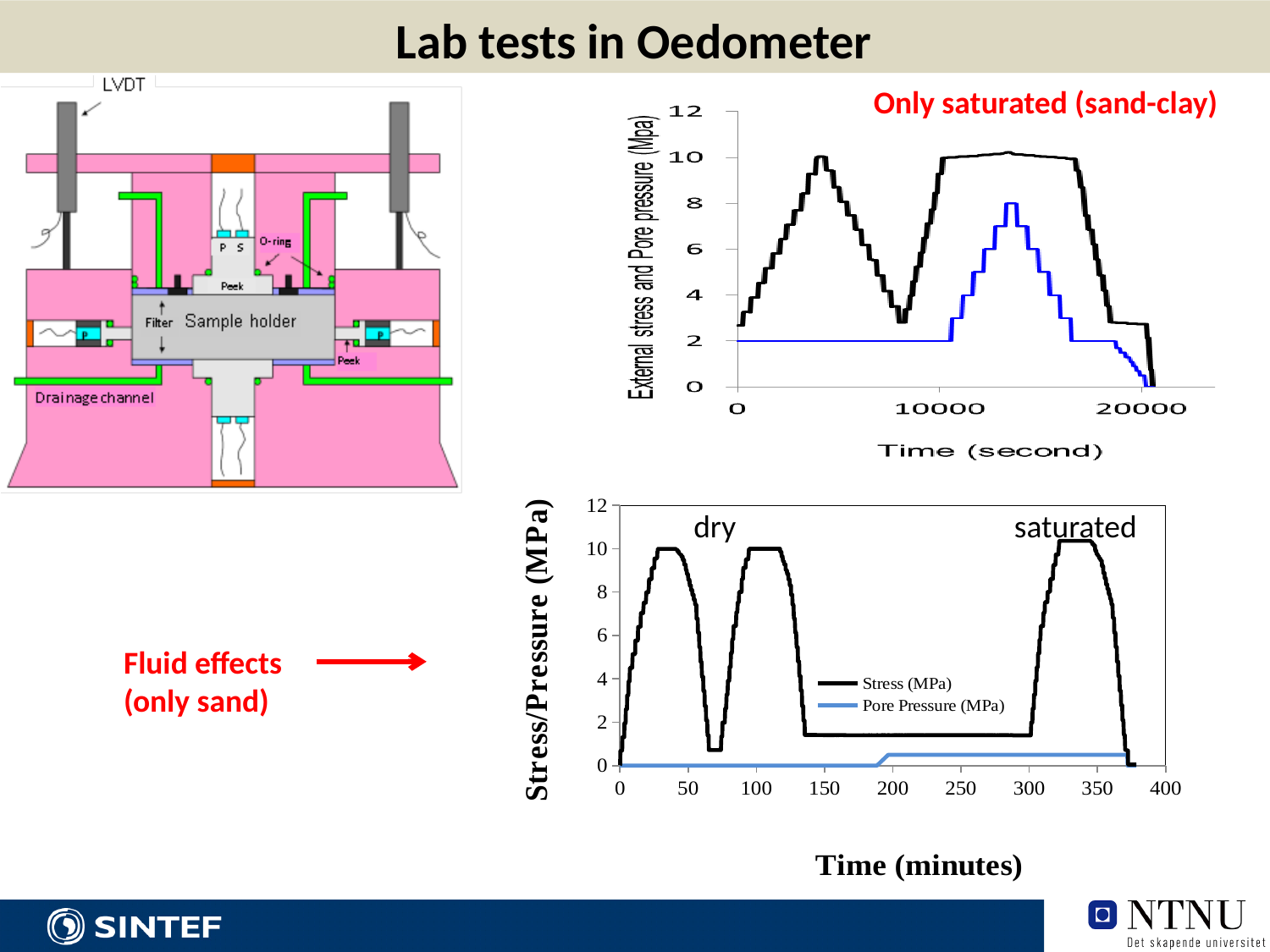
What kind of chart is the top-right chart titled Only saturated (sand-clay)? line chart In the bottom chart, does the Stress (MPa) series rise or fall between about 300 and 330 minutes? rise In the top-right chart titled Only saturated (sand-clay), which line reaches a higher peak, the black external stress line or the blue pore pressure line? the black external stress line In the top-right chart titled Only saturated (sand-clay), is the peak of the black external stress line greater or less than 8? greater In the top-right chart titled Only saturated (sand-clay), is the peak of the blue pore pressure line greater or less than 6? greater How many series does the legend of the bottom chart list? 2 In the bottom chart, what are the two series named in the legend? Stress (MPa) and Pore Pressure (MPa) What is the x-axis title of the top-right chart titled Only saturated (sand-clay)? Time (second) In the bottom chart, which series reaches higher values, Stress (MPa) or Pore Pressure (MPa)? Stress (MPa) In the bottom chart, is the maximum value of the Pore Pressure (MPa) series greater or less than 2? less What kind of chart is the bottom chart with the x axis labelled Time (minutes)? line chart